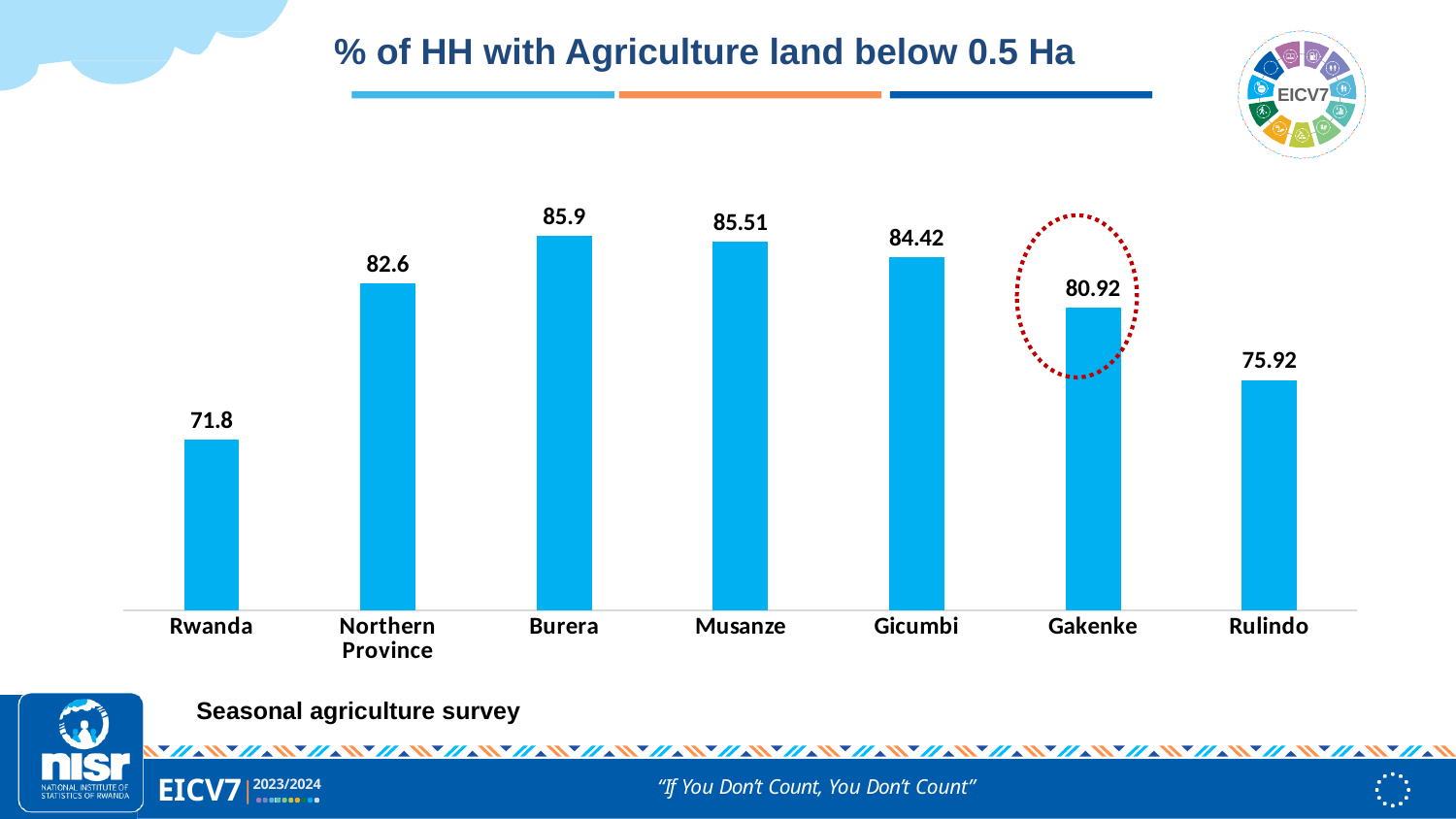
What is the value for Rulindo? 75.92 Which has a larger value, Gicumbi or Rulindo? Gicumbi How many categories are shown on the chart? 7 What is the difference between the values for Burera and Rwanda? 14.1 What is the value for Gakenke? 80.92 Which category has the lowest value? Rwanda Which category has the highest value? Burera Which category is highlighted with a red dotted circle? Gakenke What is the value for Northern Province? 82.6 What kind of chart is shown on the slide? Bar chart What is the difference between the values for Gakenke and Rulindo? 5 What is the value for Rwanda? 71.8